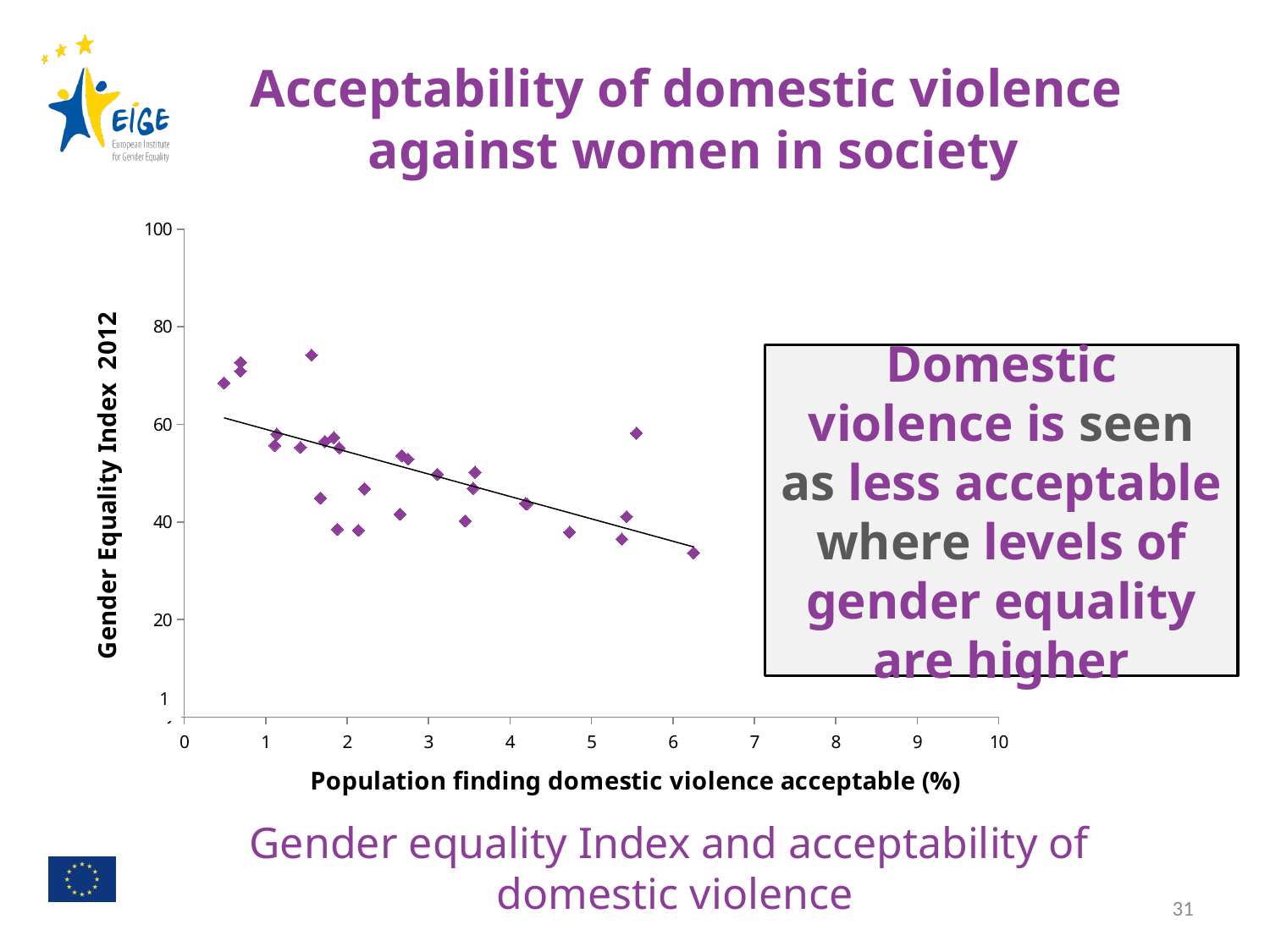
What kind of chart is shown on the slide? scatter chart Is the lowest Gender Equality Index value plotted on the chart greater or less than 40? less Is the Gender Equality Index of the leftmost point on the chart greater or less than 60? greater Is the largest x-axis value of any plotted point greater or less than 7? less What is the label of the y axis of the chart? Gender Equality Index 2012 What is the label of the x axis of the chart? Population finding domestic violence acceptable (%) Which has the higher Gender Equality Index: the leftmost point or the rightmost point on the chart? the leftmost point As the percentage of the population finding domestic violence acceptable increases along the x axis, does the Gender Equality Index generally rise or fall? fall